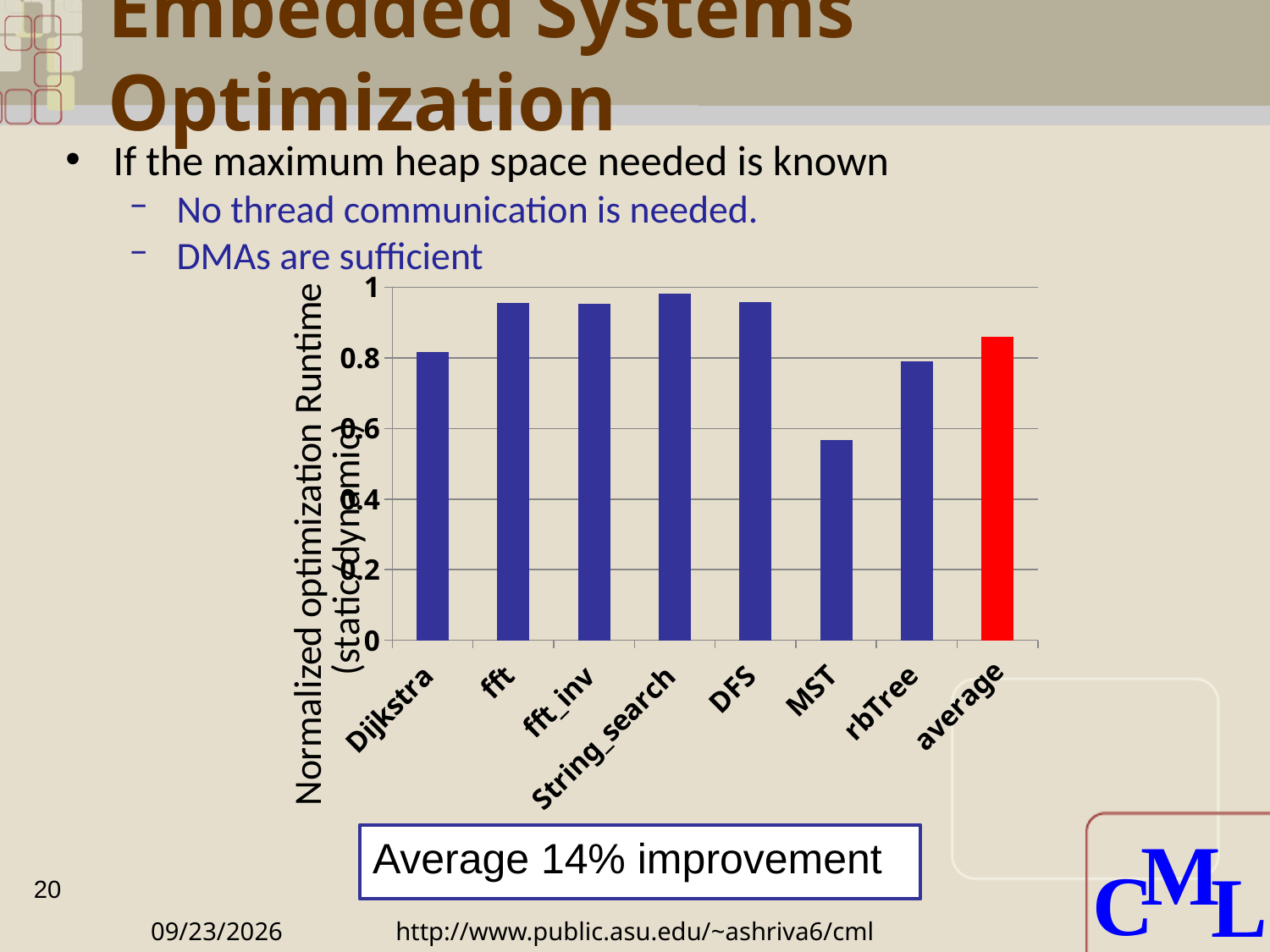
Which bar in the chart is coloured red? average Which is larger, the value for Dijkstra or the value for MST? Dijkstra Which category has the lowest bar in the chart? MST Is the value for fft greater or less than 0.8? greater Is the value for average greater or less than 0.8? greater What kind of chart is shown on the slide? bar chart Is the value for MST greater or less than 0.6? less What is the label on the y axis of the chart? Normalized optimization Runtime (static/dynamic) Which is larger, the value for rbTree or the value for fft? fft How many categories are shown on the x axis of the chart? 8